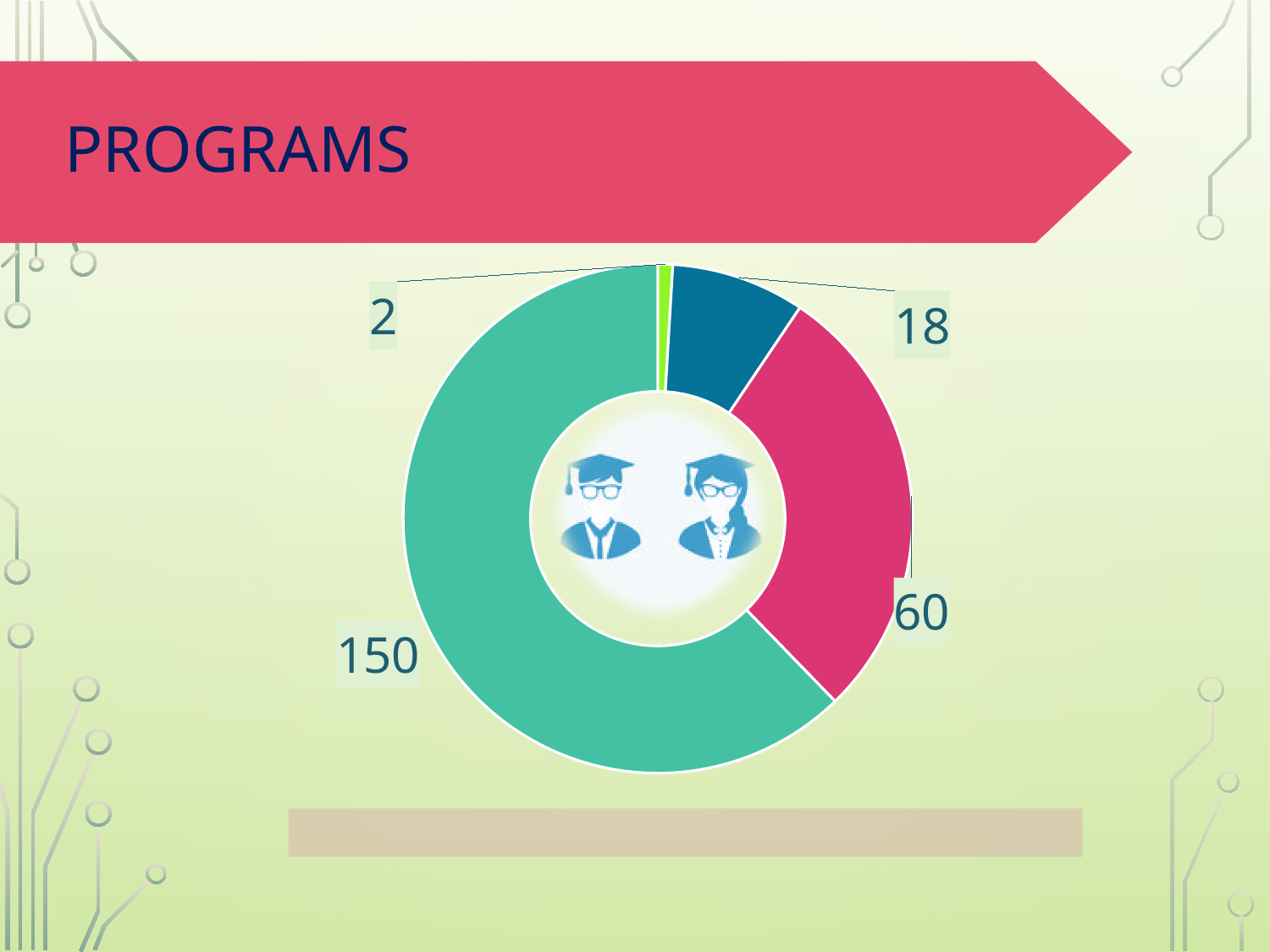
What is the smallest value shown in the doughnut chart? 2 What is the value of the pink slice of the doughnut chart? 60 What is the value of the dark blue slice of the doughnut chart? 18 How many slices does the doughnut chart have? 4 What is the difference between the two largest values in the doughnut chart, 150 and 60? 90 What is the value of the teal (largest) slice of the doughnut chart? 150 What is the total of all four values shown in the doughnut chart? 230 What is the title shown on the slide above the doughnut chart? PROGRAMS Which is larger in the doughnut chart, the pink slice or the dark blue slice? the pink slice (60) What is the largest value shown in the doughnut chart? 150 What is the difference between the values 60 and 18 in the doughnut chart? 42 What kind of chart is shown on the slide? doughnut chart